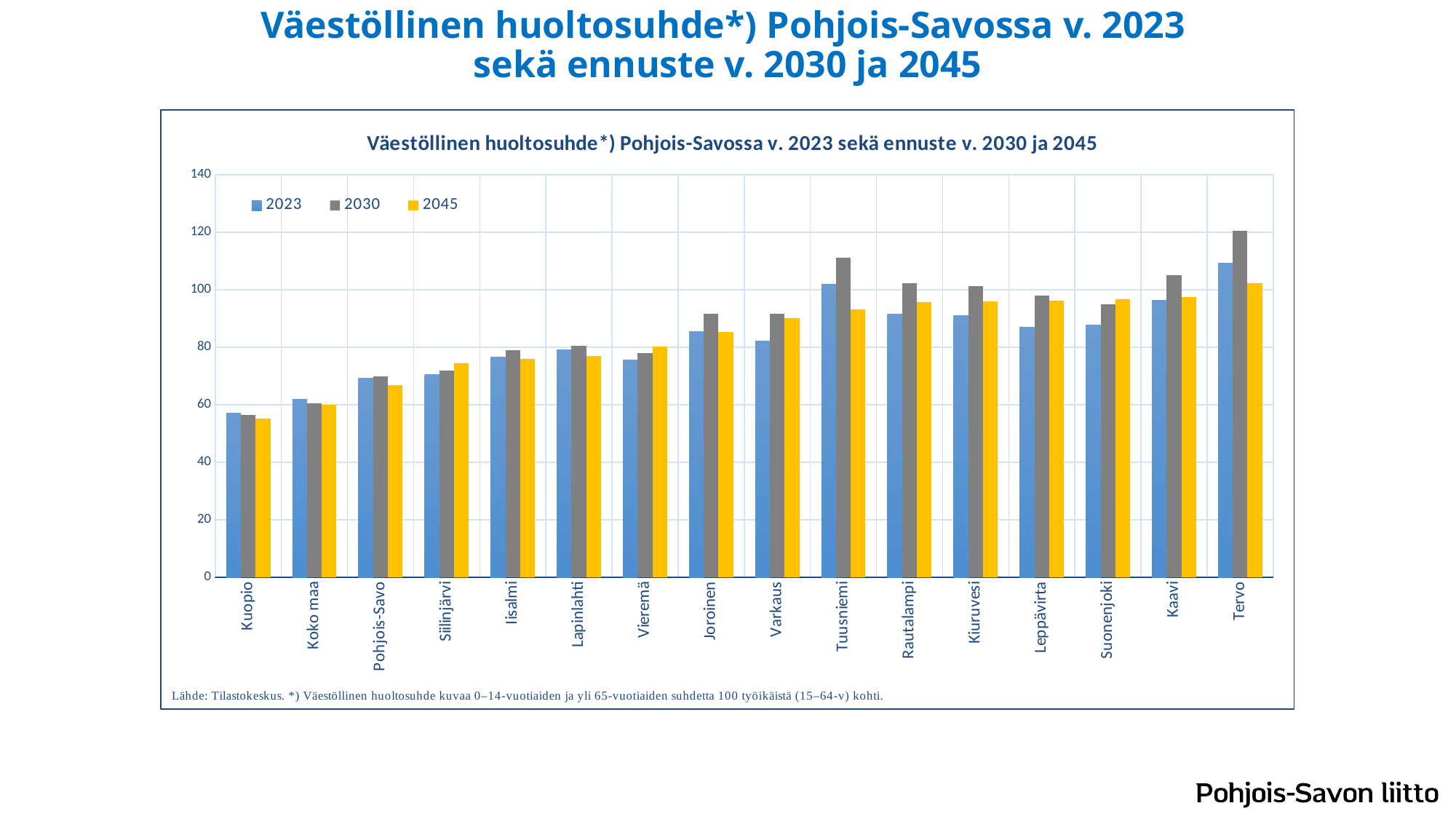
Which category has the highest value for the 2023 series? Tervo Which category has the lowest value for the 2045 series? Kuopio Which category has the highest value for the 2030 series? Tervo Do the 2023 values generally rise or fall from left to right along the x axis? rise Is the 2030 value for Tuusniemi greater or less than 100? greater How many series does the legend list? 3 What kind of chart is shown on the slide? bar chart Is the 2030 value for Tervo greater or less than 100? greater How many categories are shown on the x axis? 16 For Tuusniemi, which is larger: the 2030 value or the 2045 value? 2030 Is the 2045 value for Koko maa greater or less than 80? less Which is larger: the 2023 value for Tervo or the 2023 value for Kuopio? Tervo